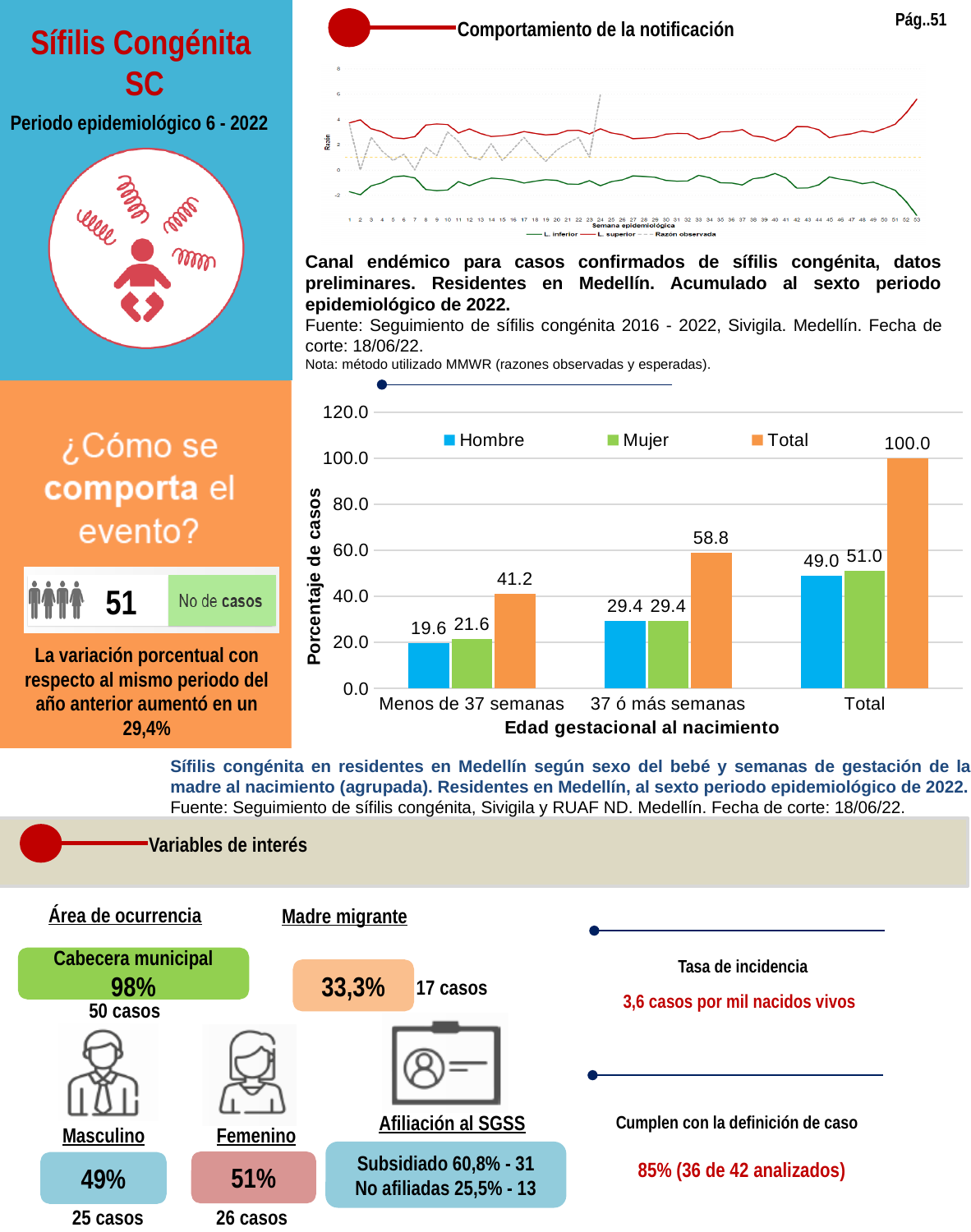
What is the y-axis title of the bar chart on the slide? Porcentaje de casos In the bar chart on the slide, which category has the highest Total value? Total In the bar chart on the slide, what is the value for Mujer in the '37 ó más semanas' category? 29.4 In the bar chart on the slide, what is the value for Hombre in the 'Menos de 37 semanas' category? 19.6 How many series does the legend of the top line chart (Comportamiento de la notificación) list? 3 In the bar chart on the slide, what is the difference between the Total values for '37 ó más semanas' and 'Menos de 37 semanas'? 17.6 In the bar chart on the slide, which is larger in the 'Total' category: Hombre or Mujer? Mujer In the bar chart on the slide, what is the value for Mujer in the 'Total' category? 51.0 In the bar chart on the slide, which category has the lowest Hombre value? Menos de 37 semanas How many series does the legend of the bar chart on the slide list? 3 In the bar chart on the slide, what is the Total value for the 'Menos de 37 semanas' category? 41.2 How many categories are shown on the x axis of the bar chart on the slide? 3